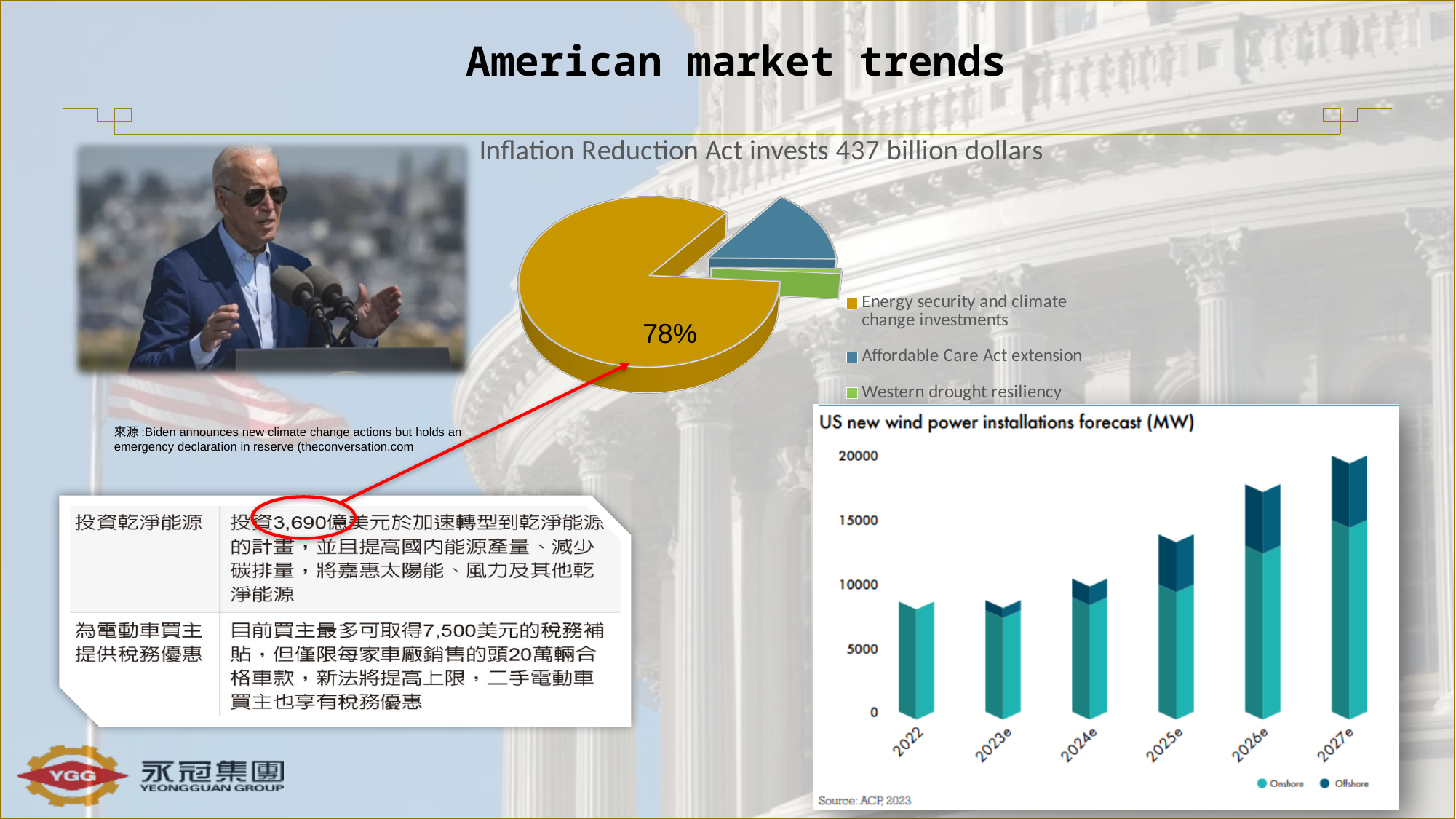
In 'US new wind power installations forecast (MW)', is the total for 2022 greater or less than 10000? less How many series does the legend of 'US new wind power installations forecast (MW)' list? 2 In 'US new wind power installations forecast (MW)', which year has the highest total installations? 2027e In 'US new wind power installations forecast (MW)', do total installations generally rise or fall from 2022 to 2027e? Rise In 'US new wind power installations forecast (MW)', is the total for 2026e greater or less than 15000? greater What kind of chart is the chart titled 'Inflation Reduction Act invests 437 billion dollars'? Pie chart Which slice of the pie chart is the largest? Energy security and climate change investments What kind of chart is 'US new wind power installations forecast (MW)'? Bar chart How many slices does the pie chart have? 3 In 'US new wind power installations forecast (MW)', which is larger, the total for 2024e or the total for 2026e? 2026e On the pie chart, what share is labelled for Energy security and climate change investments? 78% How many years are shown on the x axis of 'US new wind power installations forecast (MW)'? 6